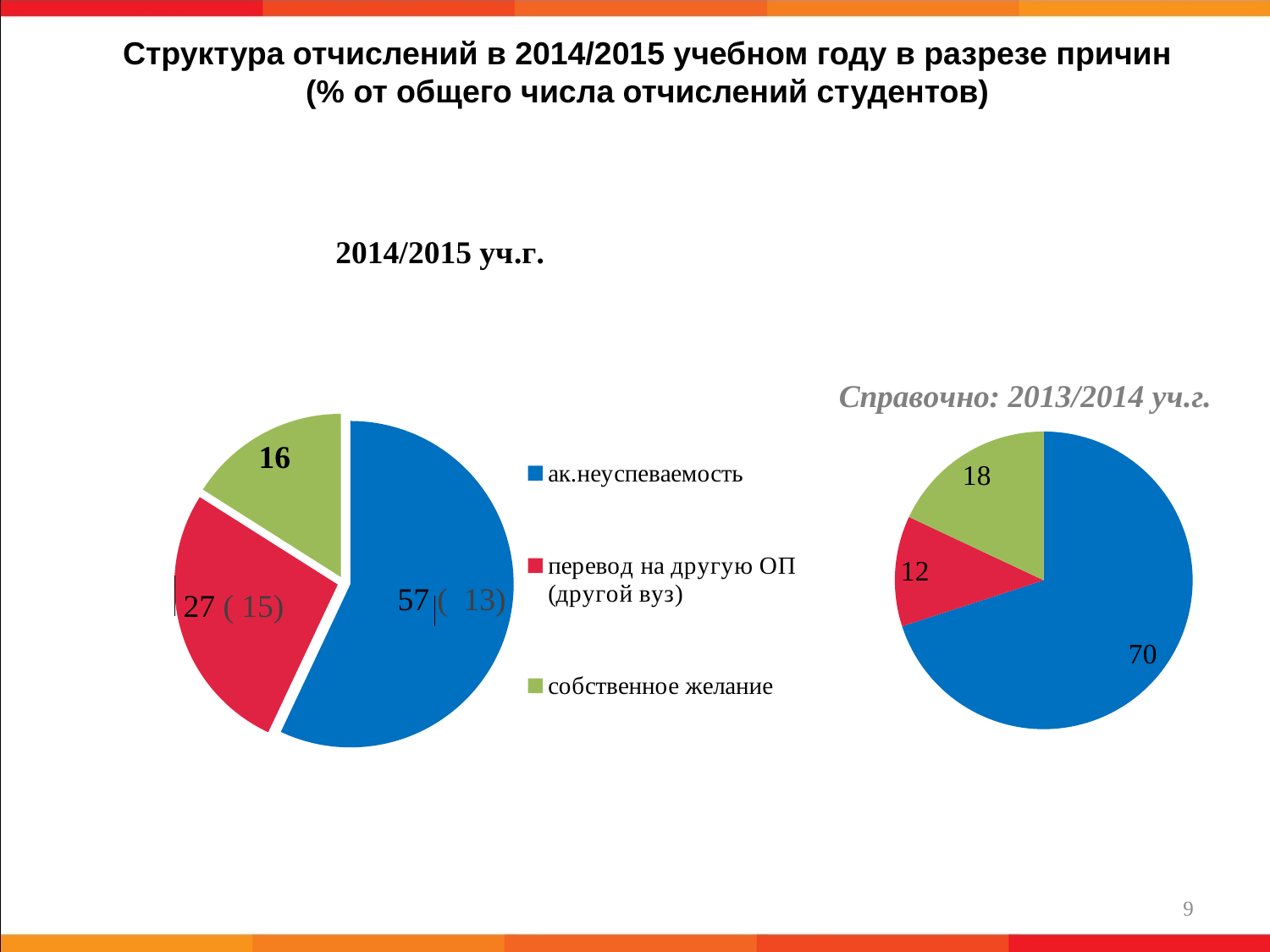
In the 2014/2015 уч.г. pie chart, what is the value for ак.неуспеваемость? 57 In the Справочно: 2013/2014 уч.г. pie chart, which category has the smallest slice? перевод на другую ОП (другой вуз) Which is larger: the value for ак.неуспеваемость in the 2014/2015 уч.г. chart or in the Справочно: 2013/2014 уч.г. chart? Справочно: 2013/2014 уч.г. In the 2014/2015 уч.г. pie chart, which category has the smallest slice? собственное желание In the Справочно: 2013/2014 уч.г. pie chart, which category has the largest slice? ак.неуспеваемость What type of chart is the Справочно: 2013/2014 уч.г. chart? Pie chart How many slices does the 2014/2015 уч.г. pie chart have? 3 In the legend, which colour represents собственное желание? Green In the Справочно: 2013/2014 уч.г. pie chart, what is the difference between the values for собственное желание and перевод на другую ОП (другой вуз)? 6 In the Справочно: 2013/2014 уч.г. pie chart, what is the value for ак.неуспеваемость? 70 In the Справочно: 2013/2014 уч.г. pie chart, what is the value for перевод на другую ОП (другой вуз)? 12 In the 2014/2015 уч.г. pie chart, what is the value for собственное желание? 16